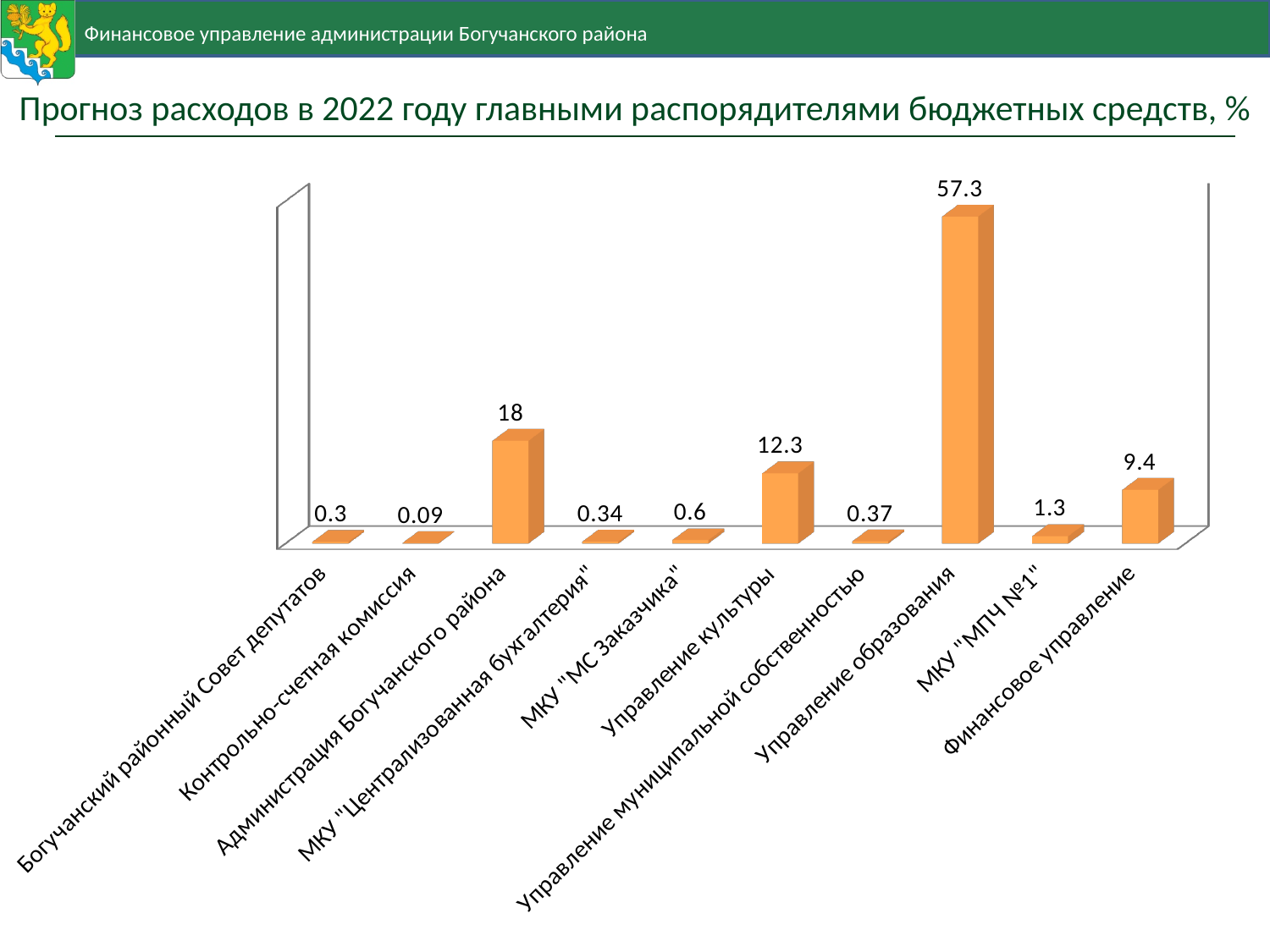
What is the value for Управление культуры? 12.3 What is the title of the chart on the slide? Прогноз расходов в 2022 году главными распорядителями бюджетных средств, % Which category has the highest value? Управление образования What is the value for Управление образования? 57.3 What kind of chart is shown on the slide? Bar chart What is the value for Администрация Богучанского района? 18 What is the value for Контрольно-счетная комиссия? 0.09 What is the value for Финансовое управление? 9.4 What is the difference between the values for Управление образования and Администрация Богучанского района? 39.3 How many categories are shown on the chart? 10 Which is larger, the value for Управление культуры or the value for Финансовое управление? Управление культуры Which category has the lowest value? Контрольно-счетная комиссия